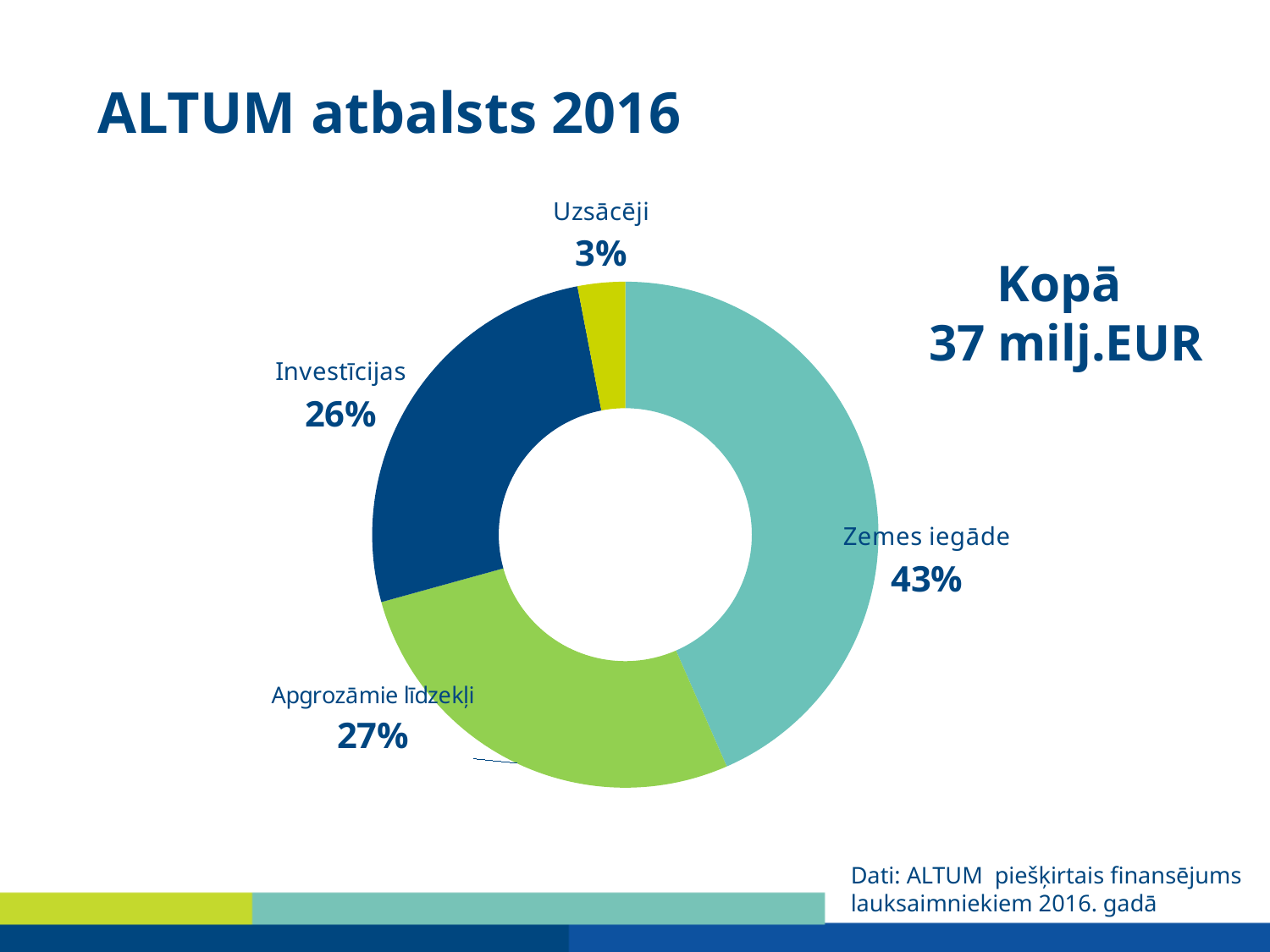
What percentage is shown for Investīcijas? 26% Which category has the largest share of the chart? Zemes iegāde What is the difference in percentage points between Apgrozāmie līdzekļi and Uzsācēji? 24 Which is larger, the share for Zemes iegāde or the share for Apgrozāmie līdzekļi? Zemes iegāde How many categories are shown in the chart? 4 What kind of chart is shown on the slide? Doughnut chart What percentage is shown for Uzsācēji? 3% Which category has the smallest share of the chart? Uzsācēji What share of the chart does Zemes iegāde account for? 43% What total amount is stated next to the chart? 37 milj.EUR What is the difference in percentage points between Zemes iegāde and Investīcijas? 17 What percentage is shown for Apgrozāmie līdzekļi? 27%